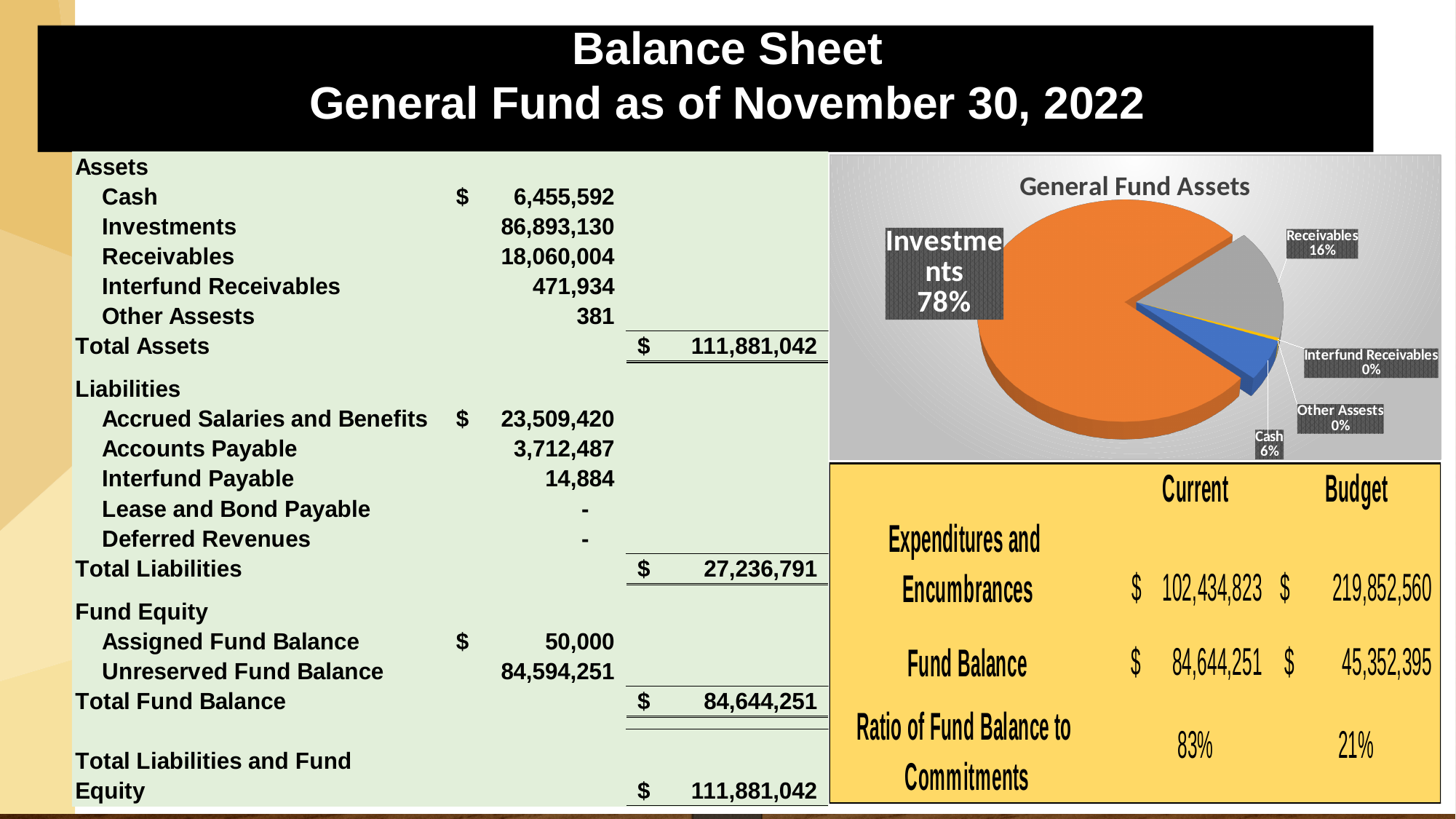
In the "General Fund Assets" pie chart, what share does Cash make up? 6% In the "General Fund Assets" pie chart, what is the difference in percentage points between the Investments share and the Receivables share? 62 In the "General Fund Assets" pie chart, what share do Investments make up? 78% Which slice is the largest in the "General Fund Assets" pie chart? Investments In the "General Fund Assets" pie chart, what share do Receivables make up? 16% In the "General Fund Assets" pie chart, which is larger: Receivables or Cash? Receivables What kind of chart is the "General Fund Assets" chart? pie chart In the "General Fund Assets" pie chart, is the Investments share greater or less than 50%? greater What colour is the Investments slice in the "General Fund Assets" pie chart? orange How many slices are labelled in the "General Fund Assets" pie chart? 5 What is the title of the pie chart on the slide? General Fund Assets